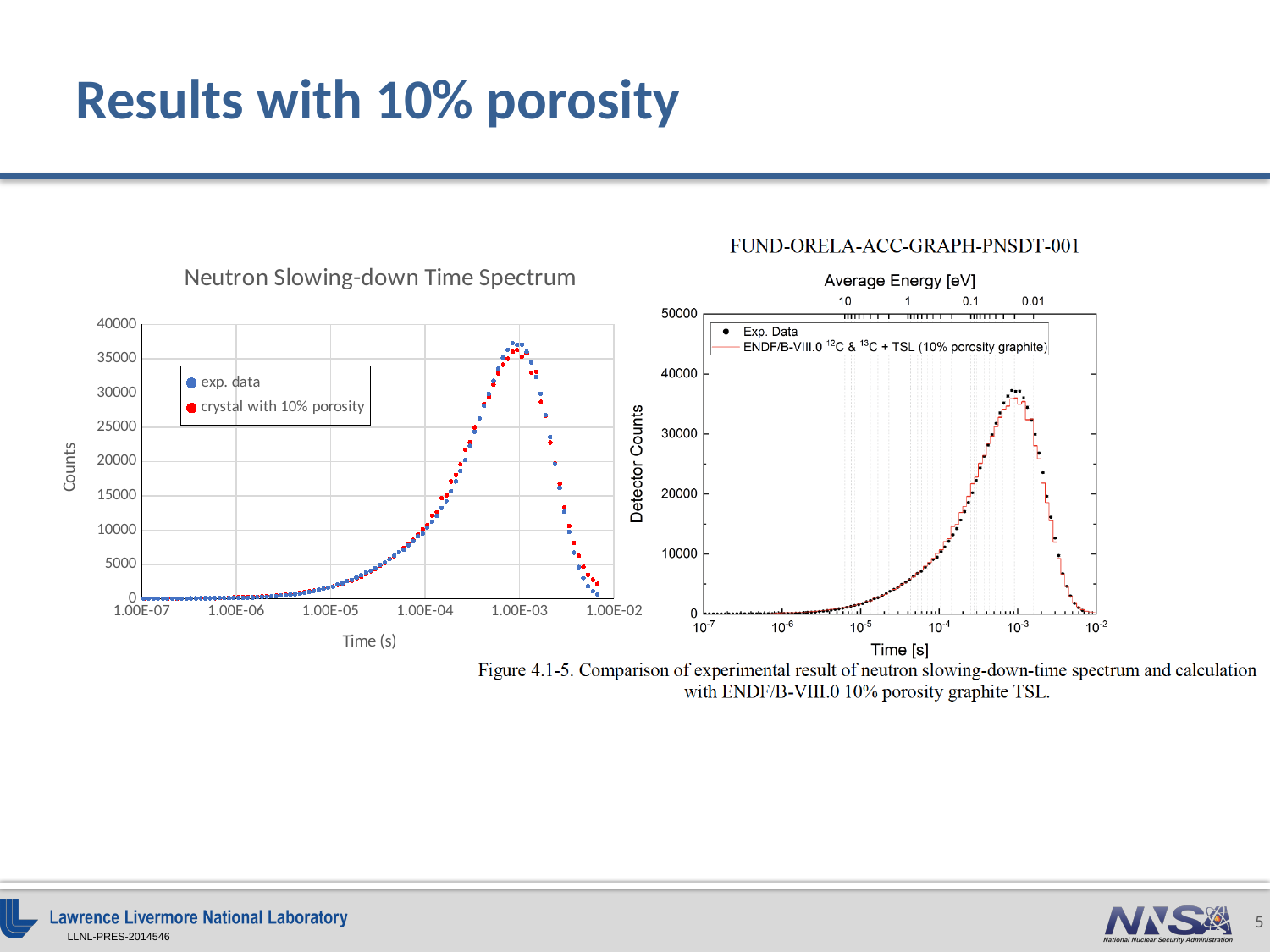
What is the title of the left chart on the slide? Neutron Slowing-down Time Spectrum How many series does the legend of the right chart 'FUND-ORELA-ACC-GRAPH-PNSDT-001' list? 2 What is the y-axis label of the right chart 'FUND-ORELA-ACC-GRAPH-PNSDT-001'? Detector Counts In the left chart 'Neutron Slowing-down Time Spectrum', are the counts at 1.00E-05 s greater or less than 5000? less What kind of chart is the left chart titled 'Neutron Slowing-down Time Spectrum'? scatter chart How many series does the legend of the left chart 'Neutron Slowing-down Time Spectrum' list? 2 In the left chart 'Neutron Slowing-down Time Spectrum', is the peak value of the exp. data series greater or less than 40000? less In the right chart 'FUND-ORELA-ACC-GRAPH-PNSDT-001', is the peak of the Exp. Data series greater or less than 40000? less In the left chart 'Neutron Slowing-down Time Spectrum', do the counts rise or fall as time goes from 1.00E-05 to 1.00E-03 s? rise In the left chart 'Neutron Slowing-down Time Spectrum', do the counts rise or fall as time goes from 1.00E-03 to 1.00E-02 s? fall